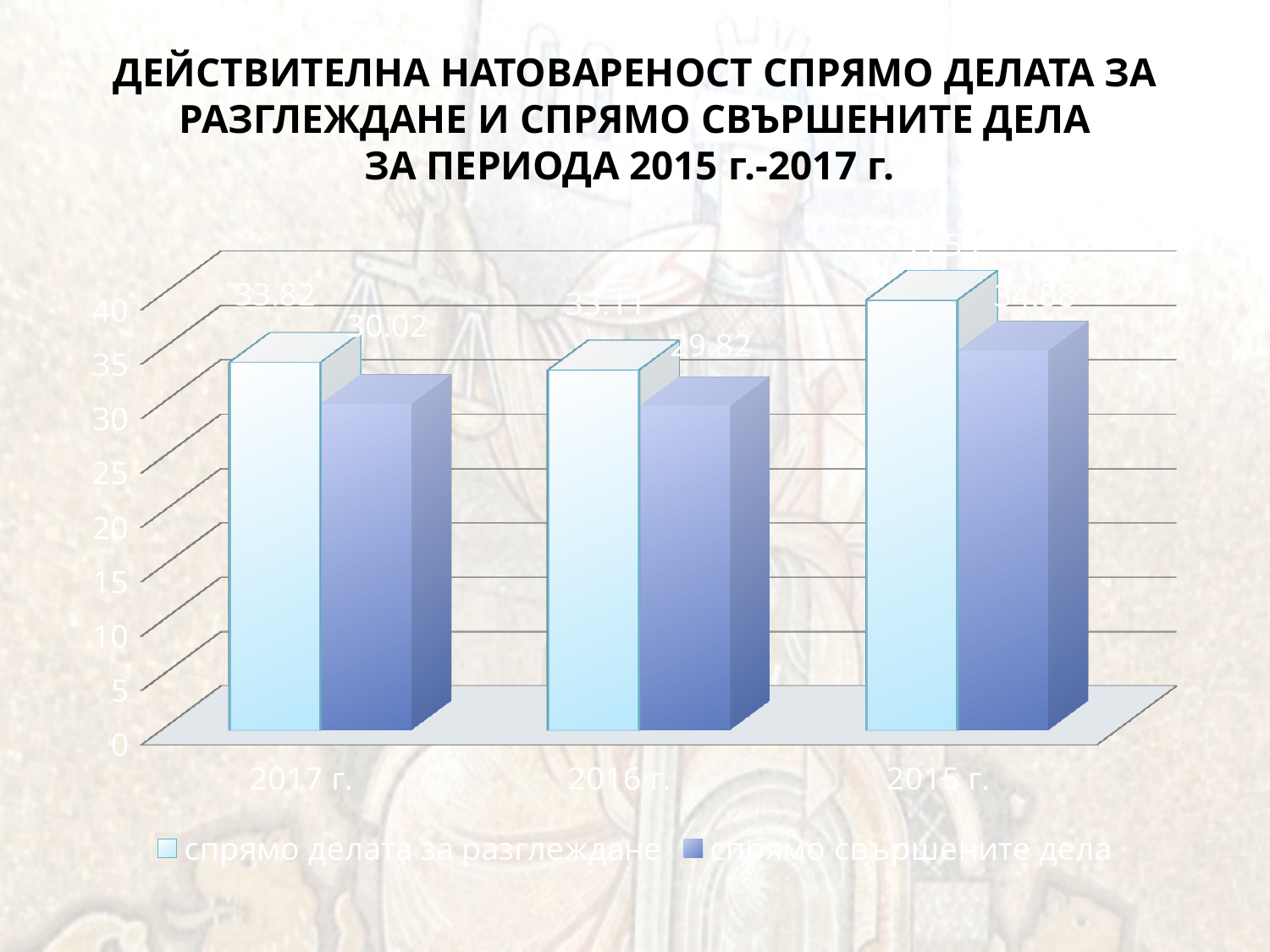
What is the value for 2017 г. in the series "спрямо делата за разглеждане"? 33.82 How many years are shown on the x axis? 3 What is the value for 2016 г. in the series "спрямо свършените дела"? 29.82 Is the value for 2015 г. in the series "спрямо делата за разглеждане" greater or less than 35? greater What kind of chart is shown on the slide? bar chart What is the value for 2015 г. in the series "спрямо свършените дела"? 34.88 What is the value for 2016 г. in the series "спрямо делата за разглеждане"? 33.11 What is the value for 2017 г. in the series "спрямо свършените дела"? 30.02 What is the difference between the two series values for 2017 г.? 3.80 Which year has the highest value in the series "спрямо делата за разглеждане"? 2015 г. How many series does the legend list? 2 What is the difference between the two series values for 2016 г.? 3.29